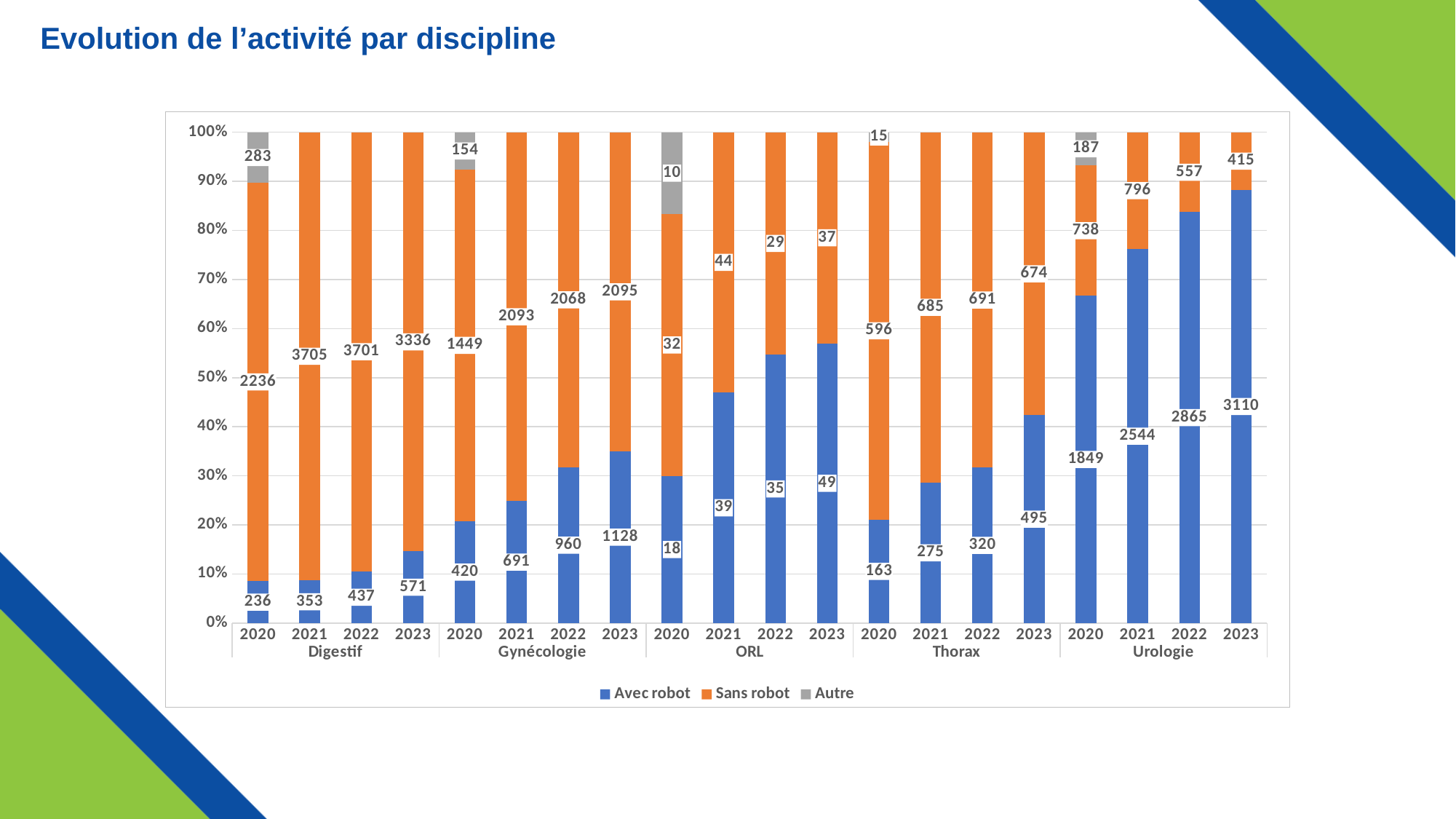
What is the 'Avec robot' value for Urologie in 2023? 3110 Which discipline and year has the highest 'Avec robot' value? Urologie 2023 What is the 'Sans robot' value for Digestif in 2021? 3705 What kind of chart is shown on the slide? Stacked bar chart Do the 'Avec robot' values for Urologie rise or fall from 2020 to 2023? Rise Which discipline and year has the lowest 'Avec robot' value? ORL 2020 Is the 'Avec robot' share for Urologie in 2023 greater or less than 80%? greater What is the 'Autre' value for Gynécologie in 2020? 154 What is the total of the ORL 2020 bar (Avec robot + Sans robot + Autre)? 60 For Gynécologie in 2023, which is larger: 'Avec robot' or 'Sans robot'? Sans robot How many series does the legend list? 3 What is the difference between the 'Avec robot' and 'Sans robot' values for Urologie in 2023? 2695